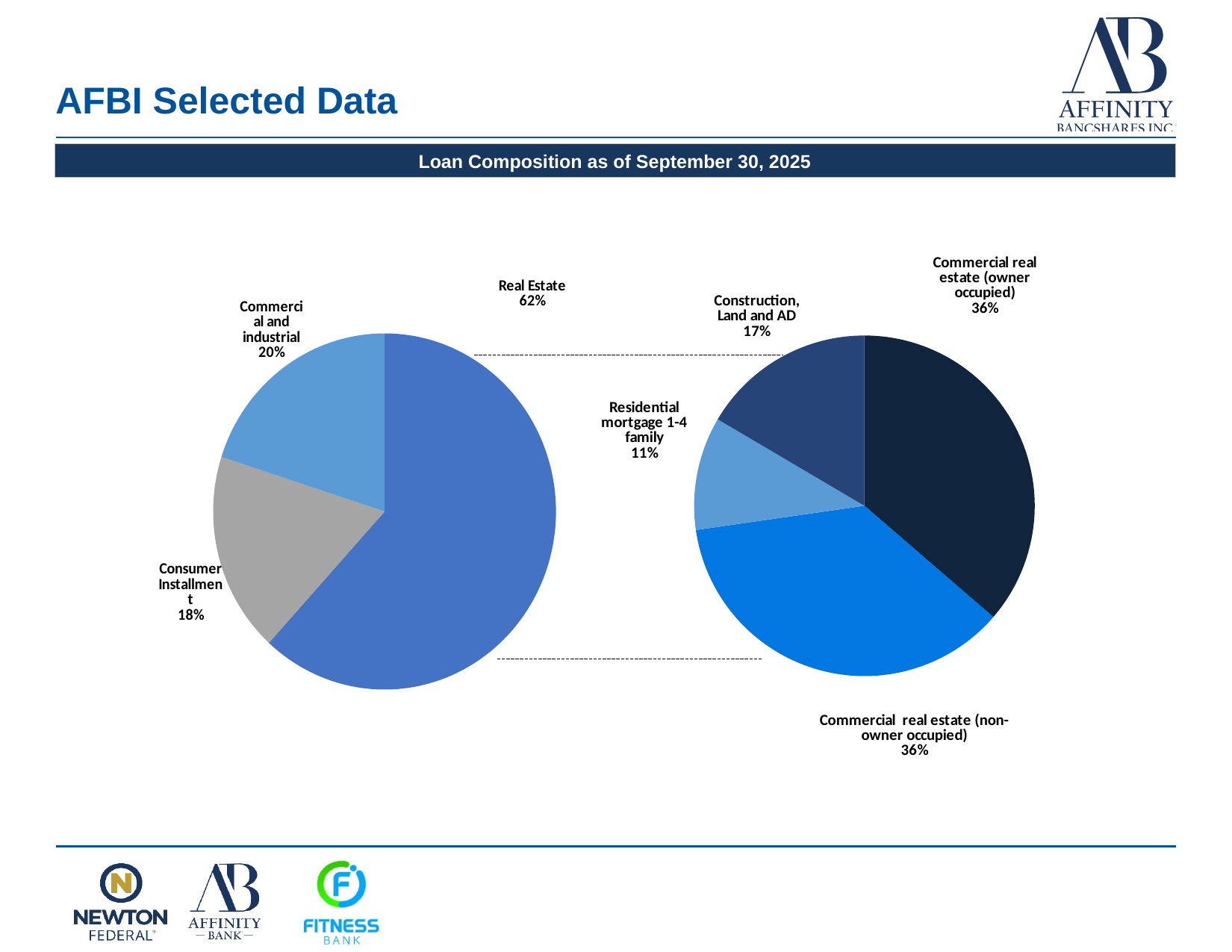
In the left pie chart, which category has the largest share? Real Estate In the right pie chart, what share is Commercial real estate (owner occupied)? 36% In the left pie chart, which category has the smallest share? Consumer Installment In the right pie chart, which is larger: Construction, Land and AD or Residential mortgage 1-4 family? Construction, Land and AD In the left pie chart, what is the difference between the Real Estate share and the Commercial and industrial share? 42% In the left pie chart, what share is Consumer Installment? 18% In the right pie chart, what share is Construction, Land and AD? 17% In the right pie chart, which category has the smallest share? Residential mortgage 1-4 family In the left pie chart, what share is Commercial and industrial? 20% How many slices does the right pie chart have? 4 What kind of chart is used on the left side of the slide? pie chart In the left pie chart, what share is Real Estate? 62%